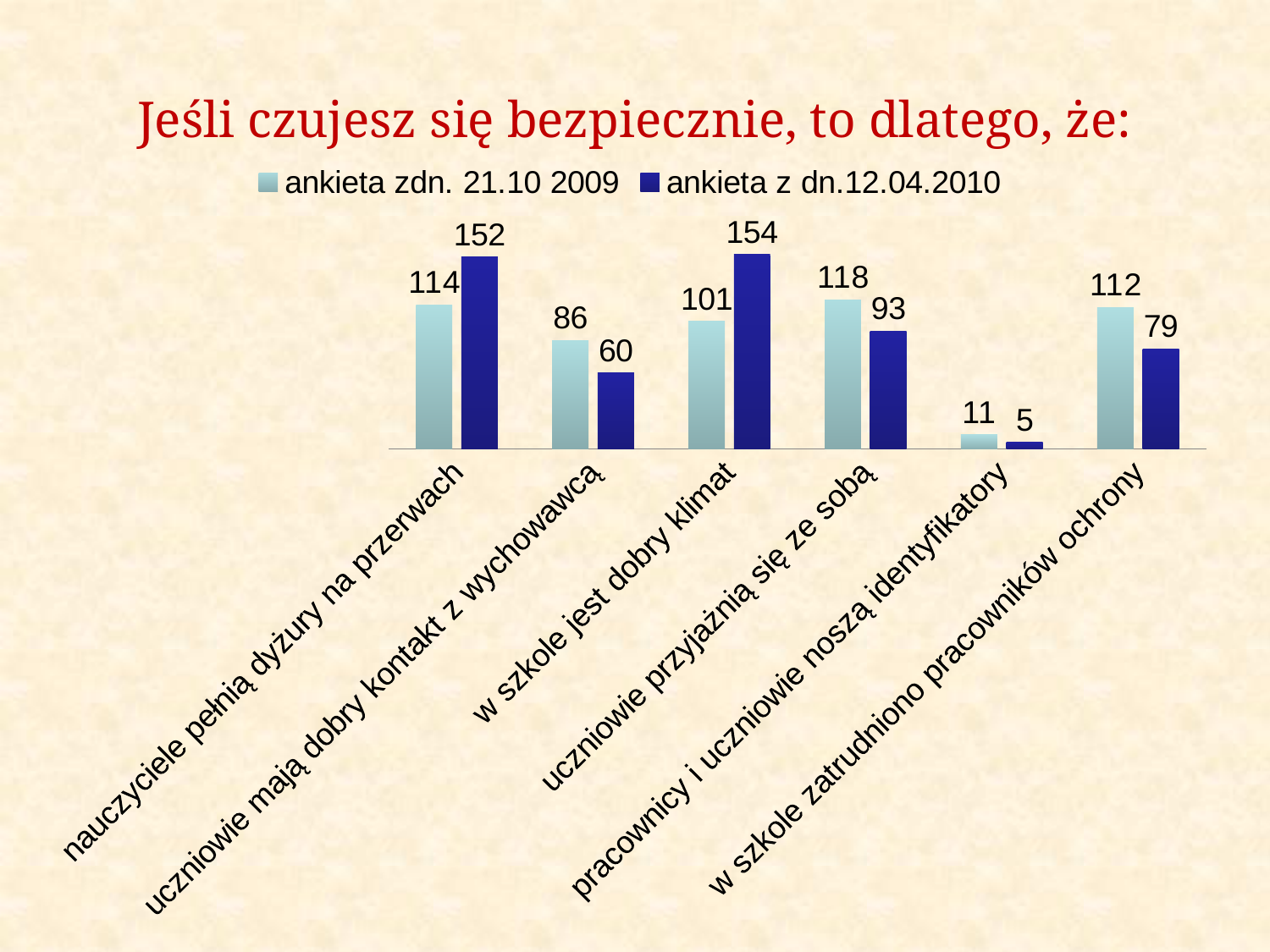
Which category has the highest value in the 'ankieta z dn.12.04.2010' series? w szkole jest dobry klimat How many categories are shown on the x axis? 6 What is the difference between the two series for 'nauczyciele pełnią dyżury na przerwach'? 38 For 'uczniowie przyjaźnią się ze sobą', which series has the larger value? ankieta zdn. 21.10 2009 What value does the 'ankieta z dn.12.04.2010' series show for 'w szkole zatrudniono pracowników ochrony'? 79 Which category has the lowest value in the 'ankieta zdn. 21.10 2009' series? pracownicy i uczniowie noszą identyfikatory What value does the 'ankieta z dn.12.04.2010' series show for 'w szkole jest dobry klimat'? 154 What is the difference between the 2009 and 2010 values for 'uczniowie mają dobry kontakt z wychowawcą'? 26 What is the title of the slide? Jeśli czujesz się bezpiecznie, to dlatego, że: How many series does the legend list? 2 What kind of chart is shown on the slide? bar chart What value does the 'ankieta zdn. 21.10 2009' series show for 'uczniowie przyjaźnią się ze sobą'? 118